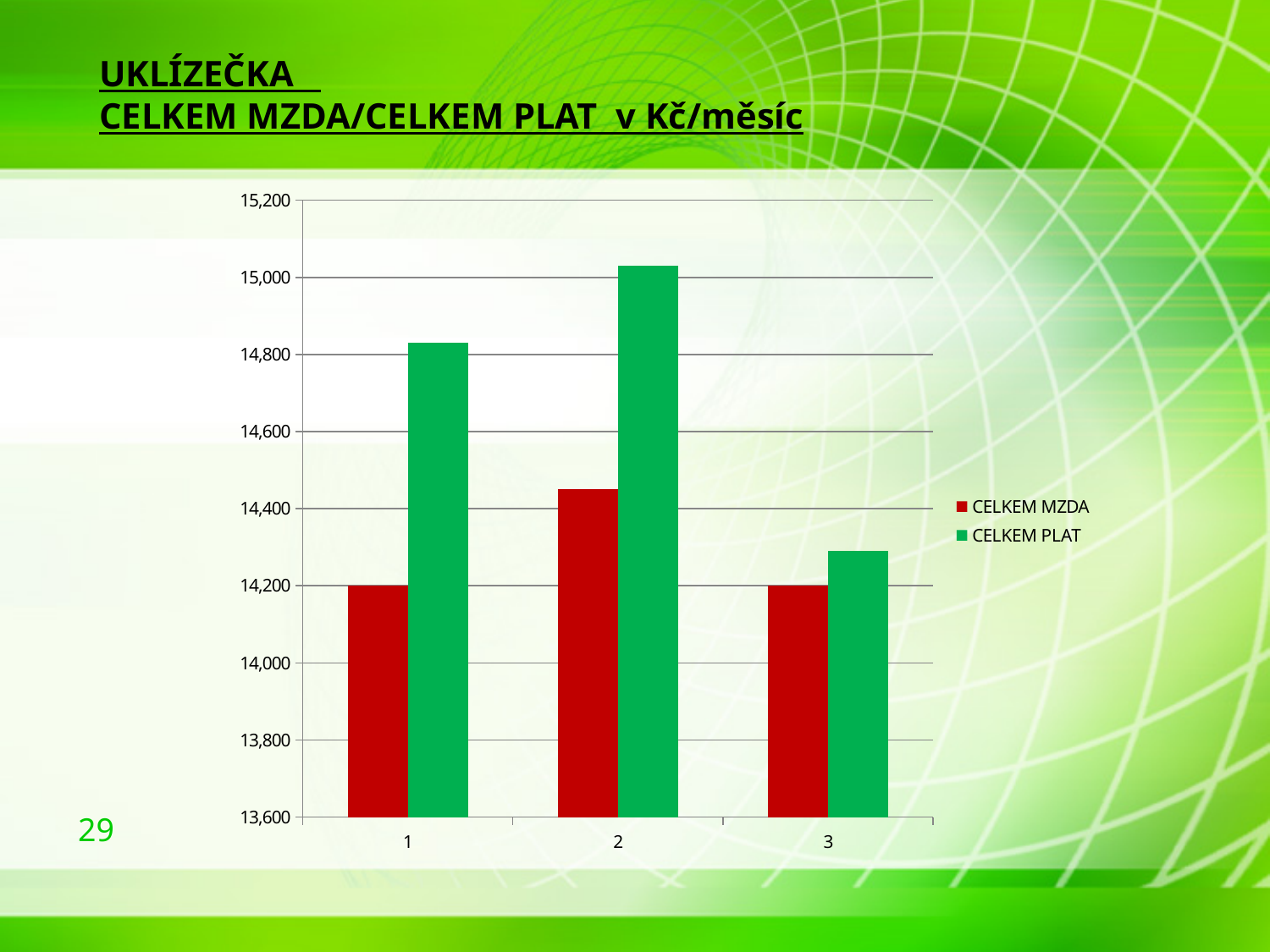
Is the value for CELKEM PLAT in category 3 greater or less than 14,400? less Is the value for CELKEM PLAT in category 2 greater or less than 15,000? greater How many series does the legend list? 2 Is the value for CELKEM MZDA in category 2 greater or less than 14,400? greater Which category has the lowest value for CELKEM PLAT? 3 How many categories are shown on the x axis? 3 Which category has the highest value for CELKEM PLAT? 2 Which category has the highest value for CELKEM MZDA? 2 What kind of chart is shown on the slide? bar chart In category 1, which is larger: CELKEM MZDA or CELKEM PLAT? CELKEM PLAT What colour are the CELKEM MZDA bars? red